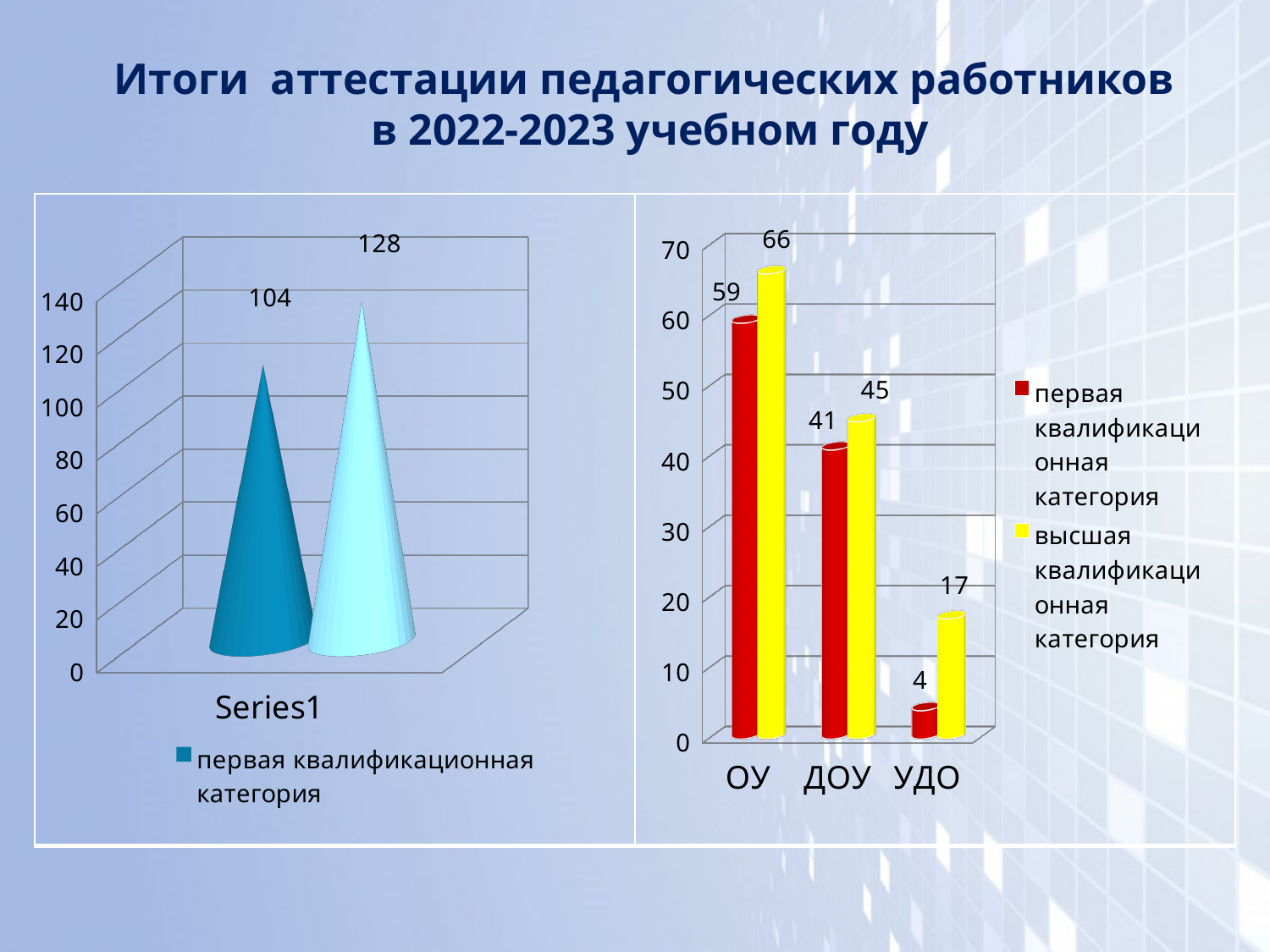
On the right chart, which category has the lowest value in the series 'первая квалификационная категория'? УДО On the right chart, what is the value for УДО in the series 'первая квалификационная категория'? 4 On the right chart, what is the value for ДОУ in the series 'высшая квалификационная категория'? 45 On the left chart, what is the value shown on the taller cone? 128 On the left chart, what is the difference between the two labelled values, 128 and 104? 24 What kind of chart is the right chart? bar chart On the right chart, which is larger for ДОУ: 'первая квалификационная категория' or 'высшая квалификационная категория'? высшая квалификационная категория On the right chart, what is the value for ОУ in the series 'первая квалификационная категория'? 59 How many series does the legend of the right chart list? 2 On the right chart, which category has the highest value in the series 'высшая квалификационная категория'? ОУ On the right chart, what is the difference between the 'высшая' and 'первая' values for УДО? 13 How many categories are shown on the x axis of the right chart? 3